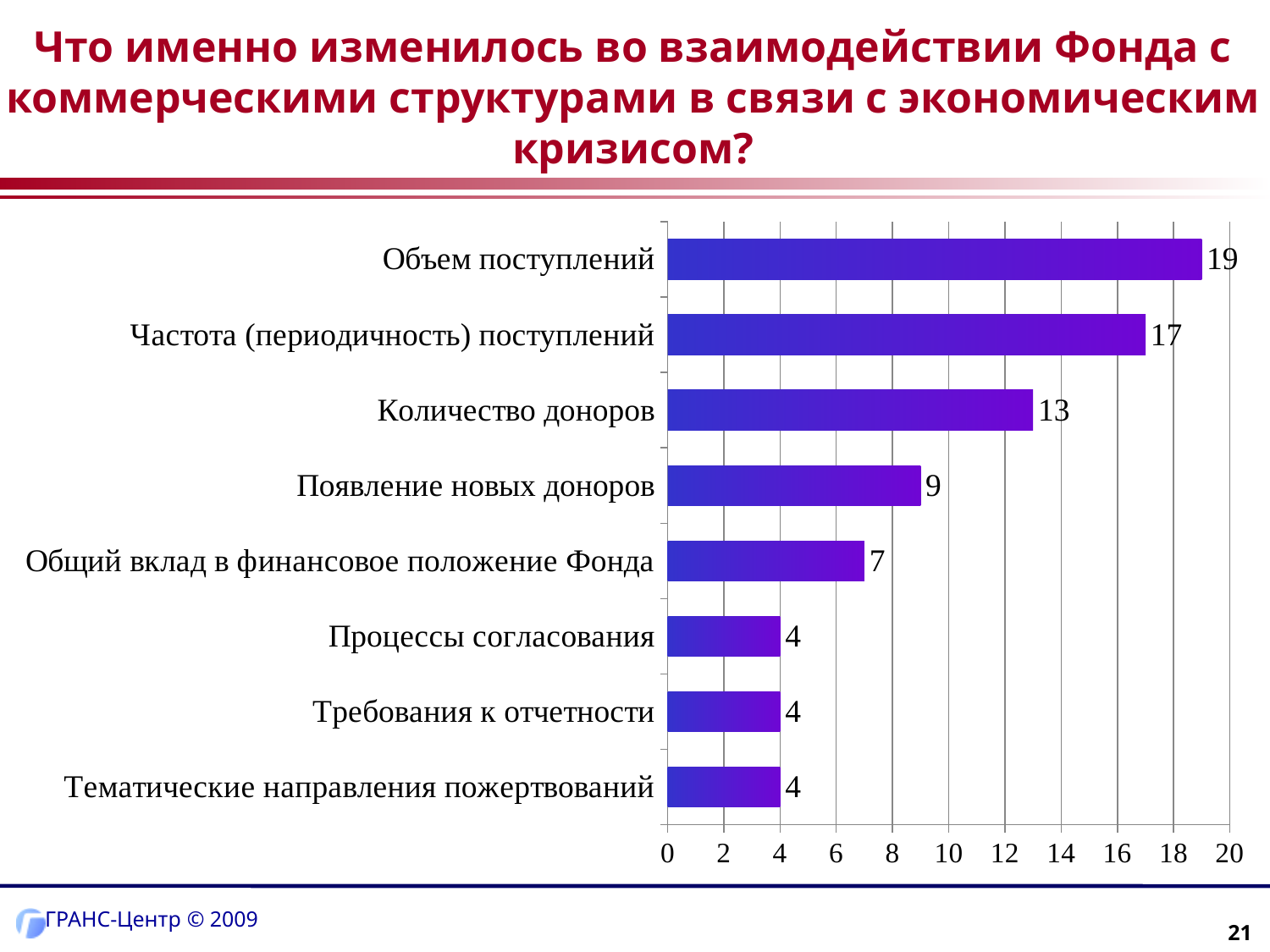
Is the value for Частота (периодичность) поступлений greater or less than 10? greater What is the difference between the values for Количество доноров and Появление новых доноров? 4 What is the value for Общий вклад в финансовое положение Фонда? 7 What is the value for Требования к отчетности? 4 What is the maximum value shown on the horizontal axis? 20 Which is larger, the value for Появление новых доноров or the value for Процессы согласования? Появление новых доноров Which category has the highest value? Объем поступлений What is the difference between the values for Объем поступлений and Частота (периодичность) поступлений? 2 What kind of chart is shown on the slide? bar chart How many categories are shown in the chart? 8 What is the value for Объем поступлений? 19 What is the value for Количество доноров? 13